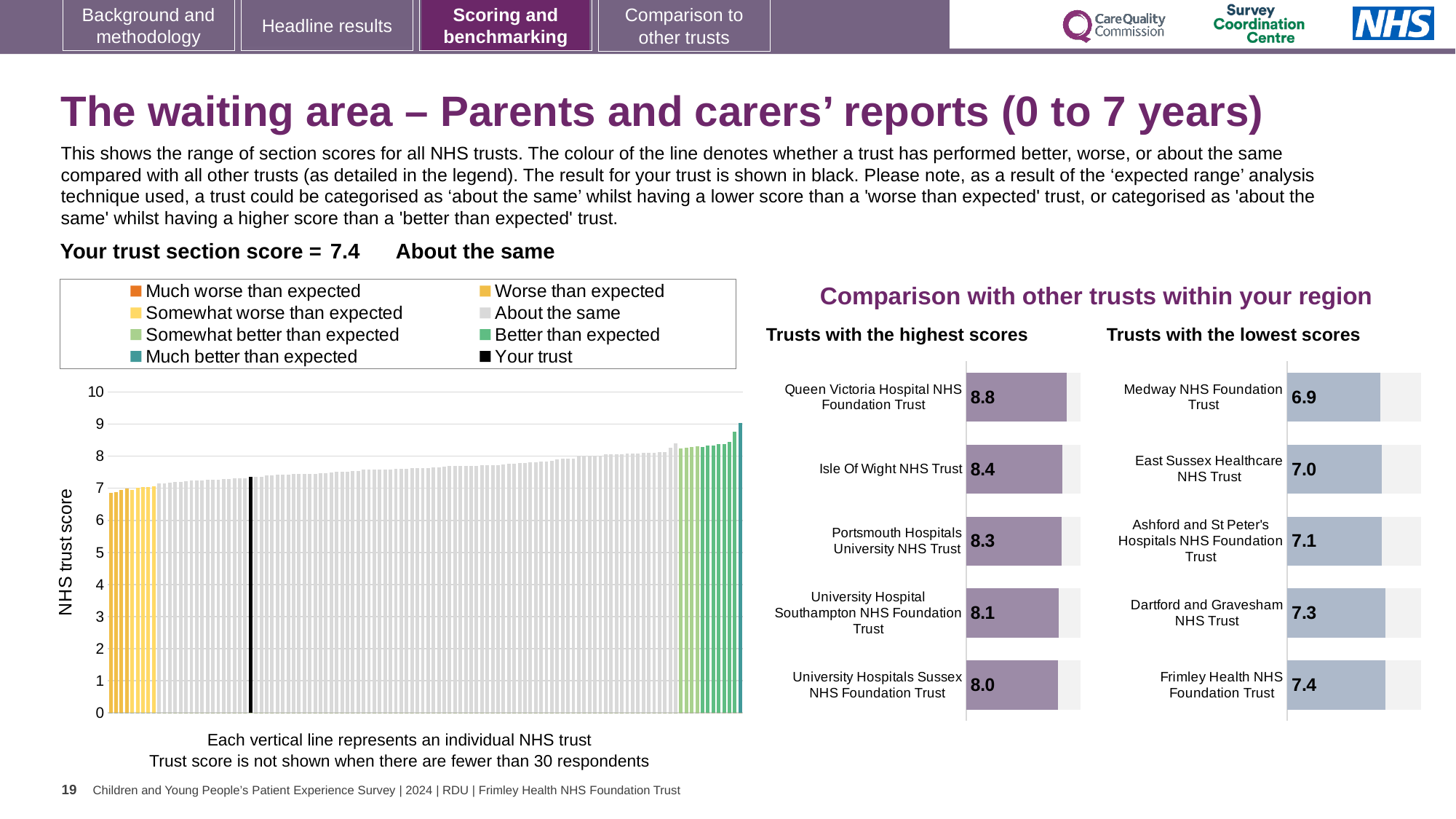
In the 'NHS trust score' chart on the left, do the bars rise or fall from left to right? Rise How many trusts are listed in the 'Trusts with the highest scores' chart? 5 How many entries does the legend of the 'NHS trust score' chart list? 8 In the 'Trusts with the lowest scores' chart, what is the score for Medway NHS Foundation Trust? 6.9 In the 'Trusts with the lowest scores' chart, what is the score for Ashford and St Peter's Hospitals NHS Foundation Trust? 7.1 In the 'Trusts with the lowest scores' chart, which has the larger score: East Sussex Healthcare NHS Trust or Dartford and Gravesham NHS Trust? Dartford and Gravesham NHS Trust In the 'Trusts with the lowest scores' chart, which trust has the highest score shown? Frimley Health NHS Foundation Trust In the 'Trusts with the highest scores' chart, what is the score for Queen Victoria Hospital NHS Foundation Trust? 8.8 What kind of chart is the 'NHS trust score' chart on the left of the slide? Bar chart In the 'NHS trust score' chart on the left, is the value of the tallest bar greater or less than 8? greater In the 'Trusts with the highest scores' chart, what is the difference between the scores of Queen Victoria Hospital NHS Foundation Trust and Isle Of Wight NHS Trust? 0.4 In the 'Trusts with the highest scores' chart, which trust has the lowest score shown? University Hospitals Sussex NHS Foundation Trust